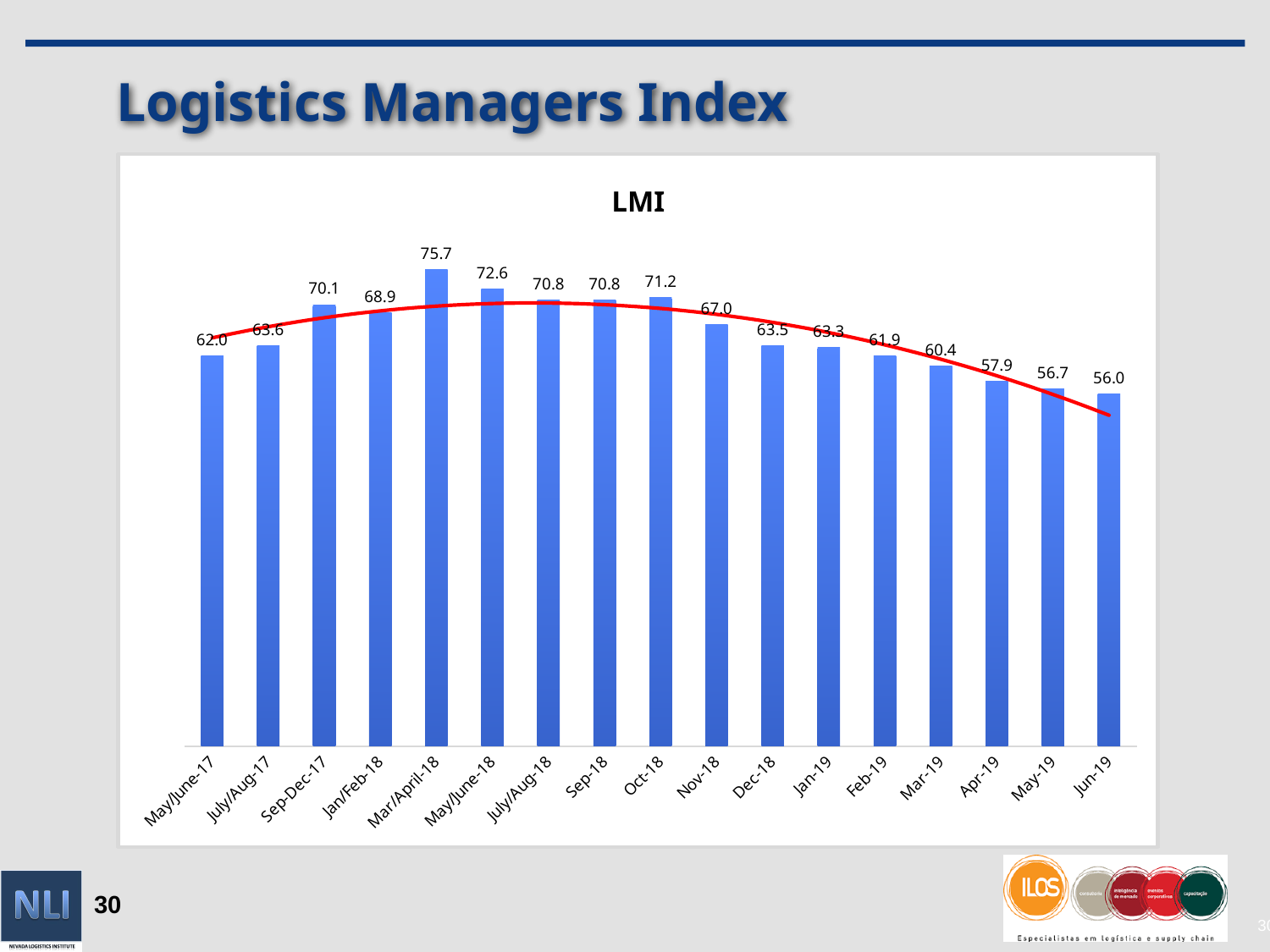
What is the LMI value for Mar/April-18? 75.7 What is the title of the chart? LMI Which period has the lowest LMI value? Jun-19 Do the LMI values rise or fall from Oct-18 to Jun-19? Fall What kind of chart is the LMI chart? Bar chart What is the LMI value for Nov-18? 67.0 Which period has the highest LMI value? Mar/April-18 How many periods are shown on the x axis of the LMI chart? 17 What is the LMI value for Jun-19? 56.0 What is the difference between the LMI values for Mar/April-18 and Jun-19? 19.7 What is the difference between the LMI values for Oct-18 and Nov-18? 4.2 Which is larger, the LMI value for Sep-Dec-17 or for Jan/Feb-18? Sep-Dec-17